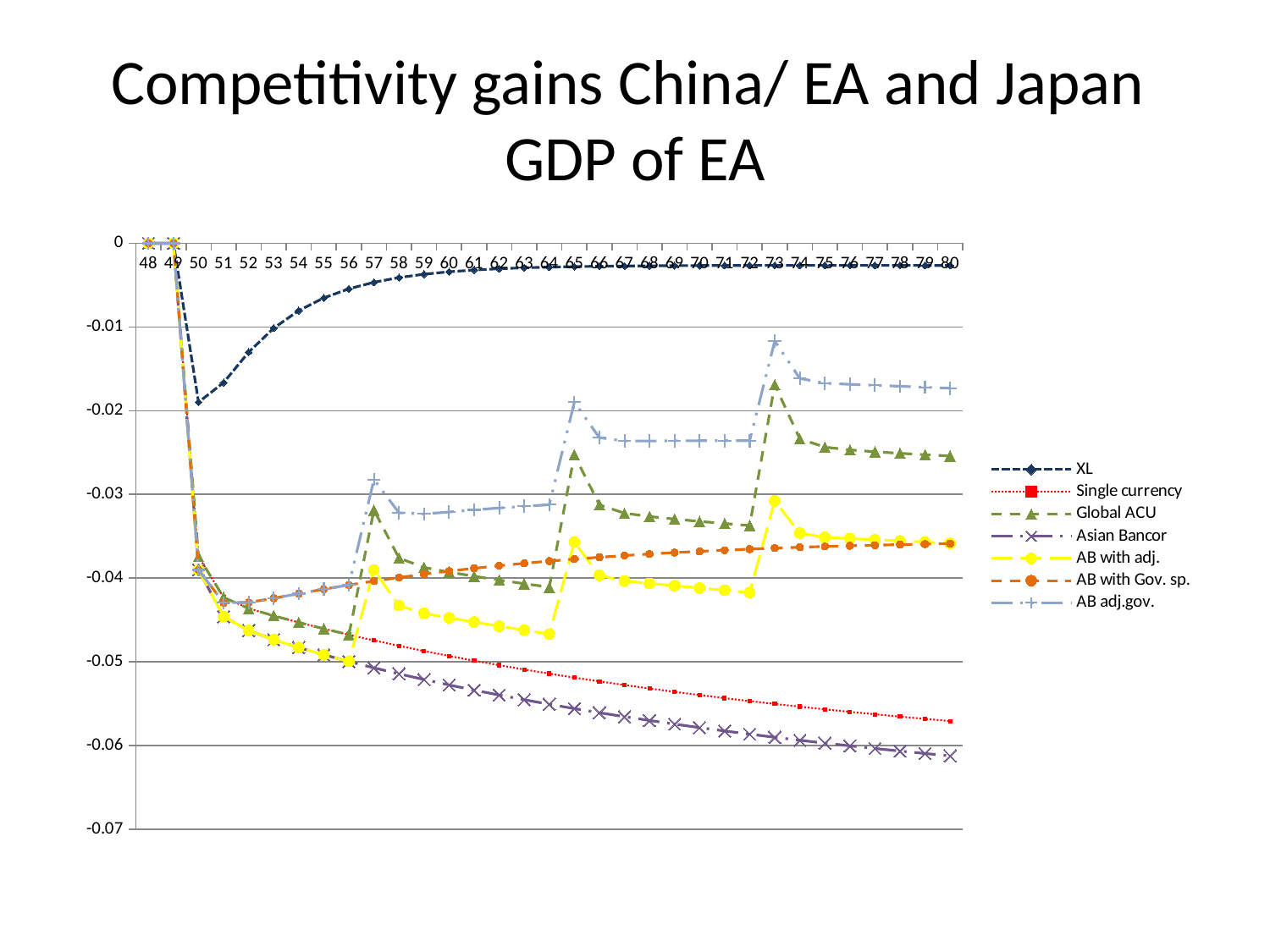
How many series does the legend list? 7 How many points are on the x axis (from 48 to 80)? 33 Is the value for XL at 80 greater or less than -0.01? greater Does the Asian Bancor series rise or fall from 49 to 80? fall Which series has the lowest value at 80? Asian Bancor Is the value for AB adj.gov. at 80 greater or less than -0.02? greater At 80, which is larger: Single currency or Asian Bancor? Single currency What is the value of the XL series at 48? 0 What kind of chart is shown on the slide? line chart Which series has the highest value at 80? XL What is the title of the chart? Competitivity gains China/ EA and Japan GDP of EA